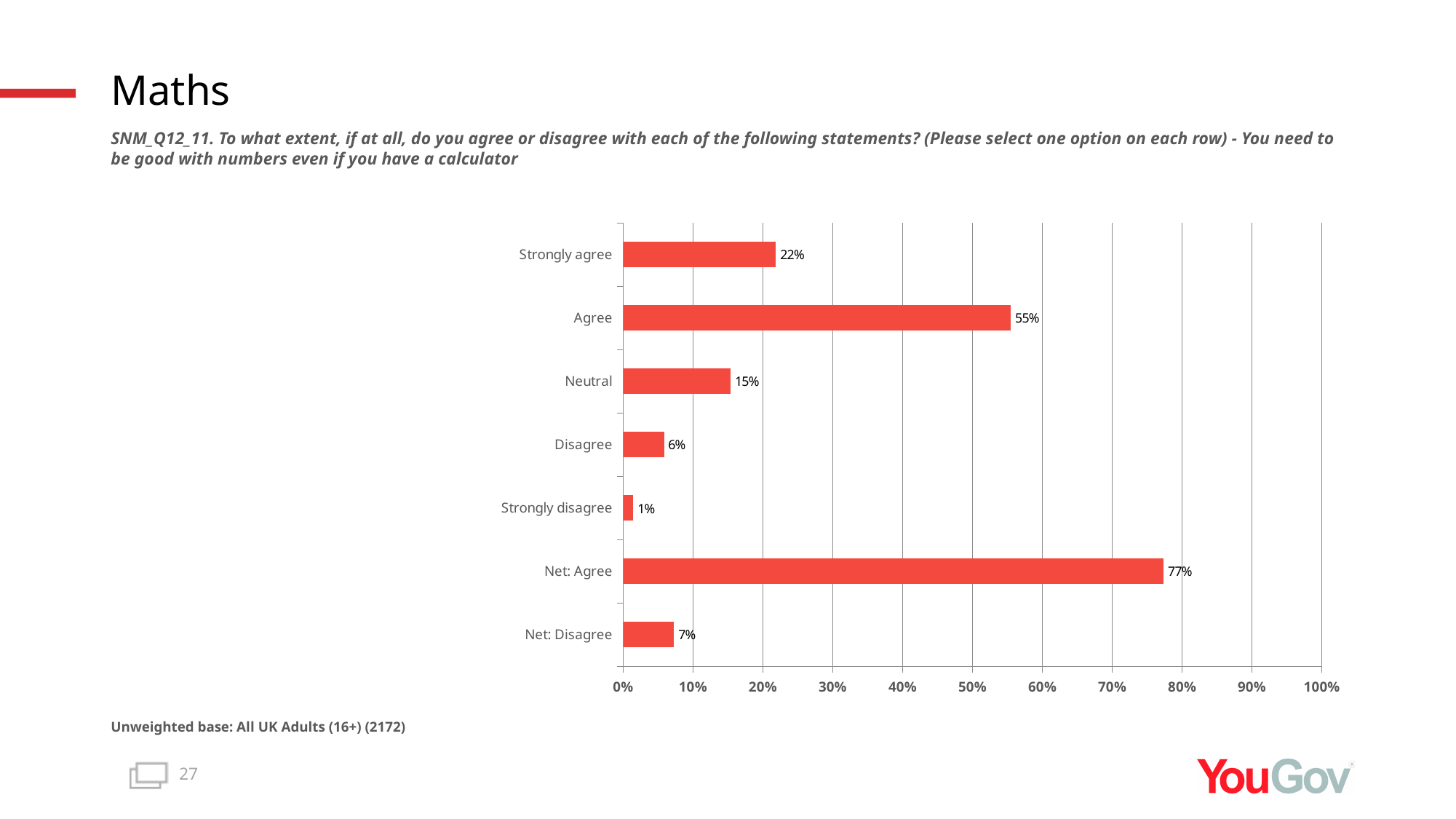
What is the value shown for 'Strongly disagree'? 1% Is the value for 'Agree' greater or less than 50%? greater What is the difference between 'Agree' and 'Strongly agree'? 33% Which category has the highest value? Net: Agree What kind of chart is shown on the slide? Bar chart What is the difference between 'Net: Agree' and 'Net: Disagree'? 70% What is the value shown for 'Net: Agree'? 77% What is the unweighted base stated below the chart? All UK Adults (16+) (2172) Which category has the lowest value? Strongly disagree How many categories are shown on the chart? 7 Which is larger, 'Neutral' or 'Disagree'? Neutral What percentage of respondents selected 'Agree'? 55%